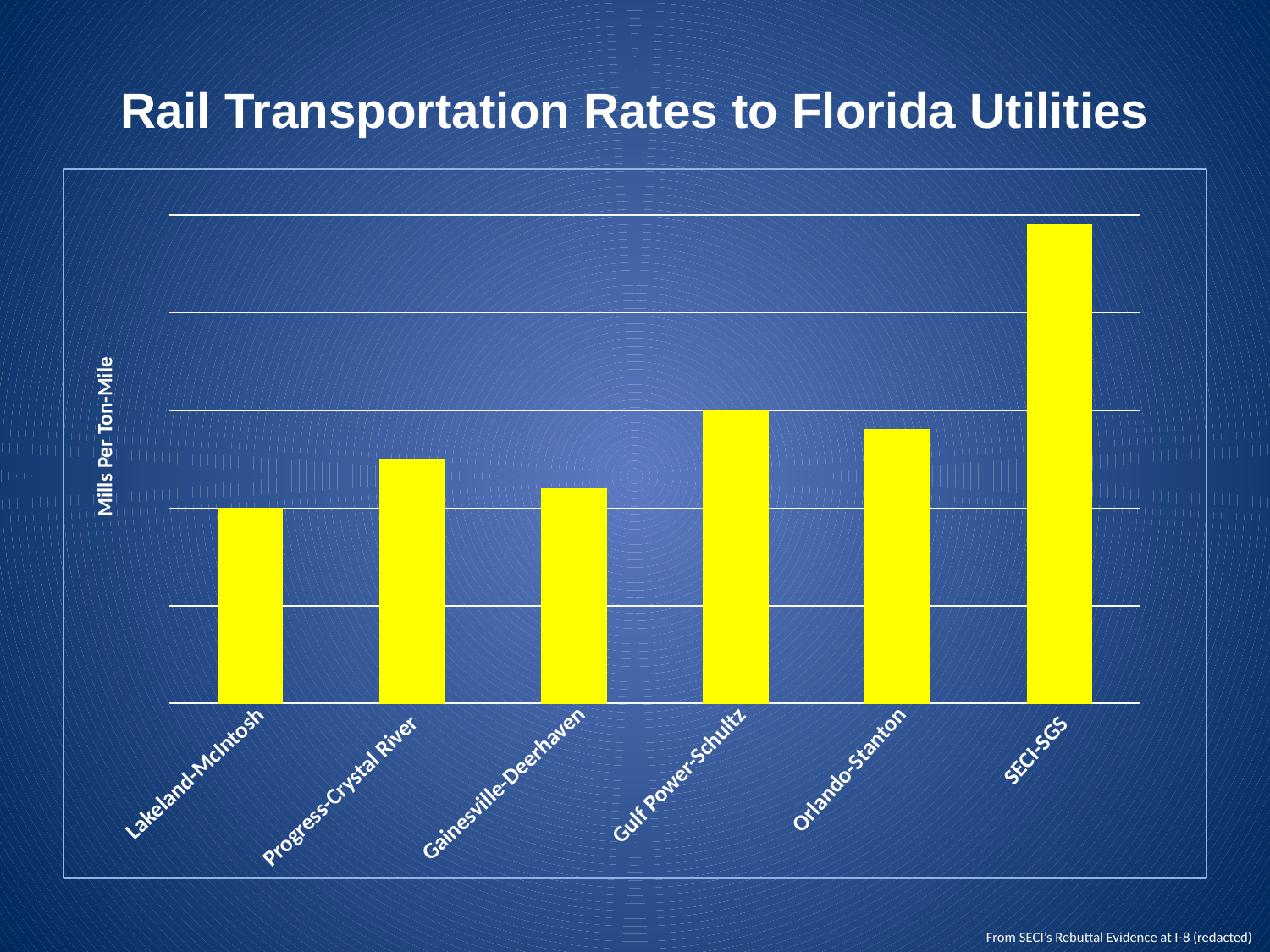
What is the label on the vertical axis of the chart? Mills Per Ton-Mile Which has a higher rate, Lakeland-McIntosh or Gainesville-Deerhaven? Gainesville-Deerhaven Which has a higher rate, SECI-SGS or Orlando-Stanton? SECI-SGS Which utility has the second-highest rail transportation rate? Gulf Power-Schultz How many utilities (bars) are shown in the chart? 6 What type of chart is shown on the slide? bar chart Which has a higher rate, Progress-Crystal River or Gainesville-Deerhaven? Progress-Crystal River Which utility has the lowest rail transportation rate? Lakeland-McIntosh Which utility has the highest rail transportation rate? SECI-SGS What is the title of the chart? Rail Transportation Rates to Florida Utilities